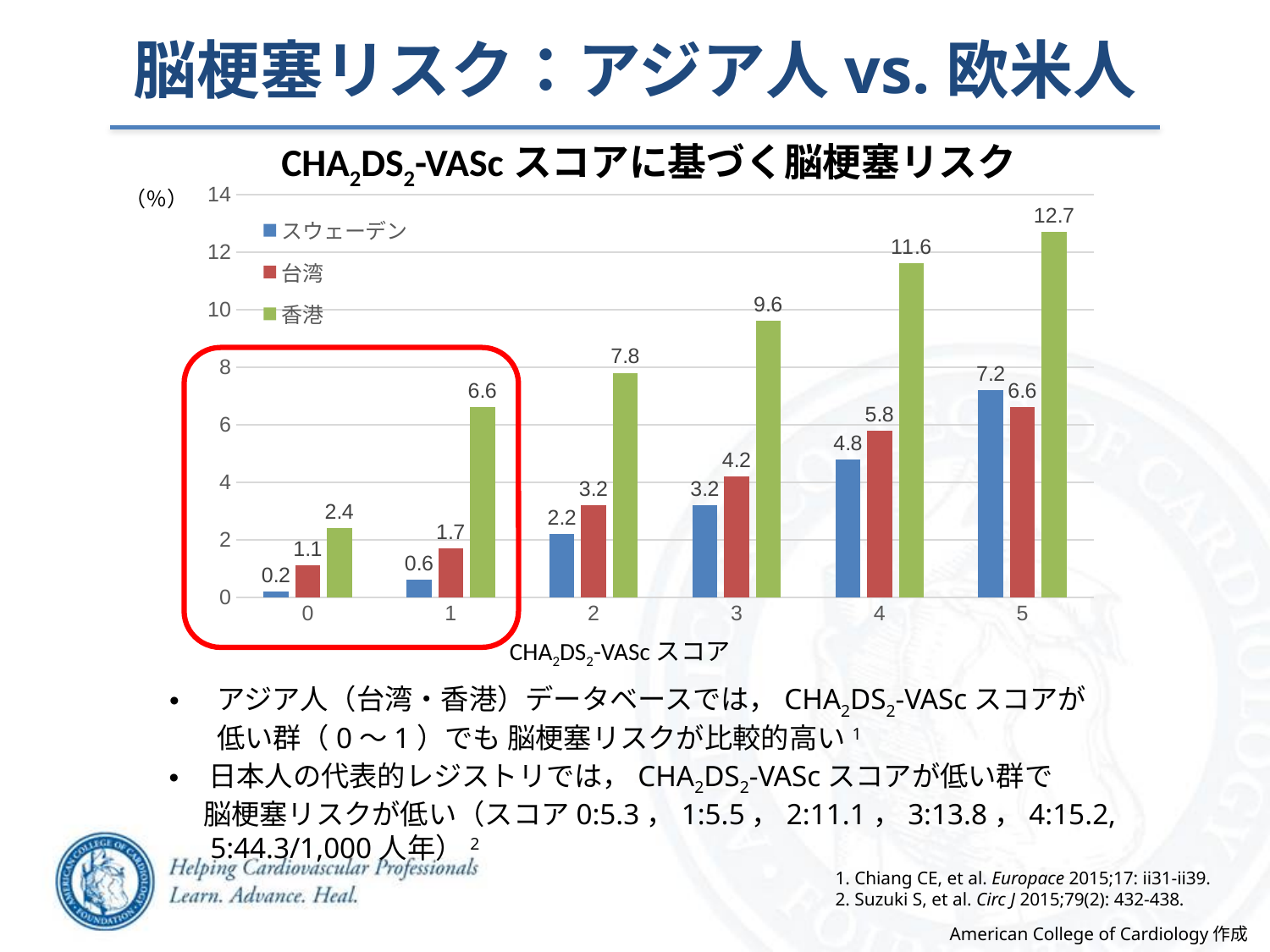
What is the difference between the 香港 and スウェーデン values at CHA2DS2-VASc score 1? 6.0 At which CHA2DS2-VASc score is the スウェーデン value lowest? 0 What is the value for スウェーデン at CHA2DS2-VASc score 0? 0.2 How many series does the chart legend list? 3 How many CHA2DS2-VASc score categories are shown on the x axis? 6 At which CHA2DS2-VASc score is the 香港 value highest? 5 What type of chart is shown on the slide? bar chart Which series is shown in green in the chart? 香港 Do the 香港 values rise or fall as the CHA2DS2-VASc score increases from 0 to 5? rise What is the value for 台湾 at CHA2DS2-VASc score 3? 4.2 What is the value for 香港 at CHA2DS2-VASc score 5? 12.7 At CHA2DS2-VASc score 5, which is larger, the スウェーデン value or the 台湾 value? スウェーデン